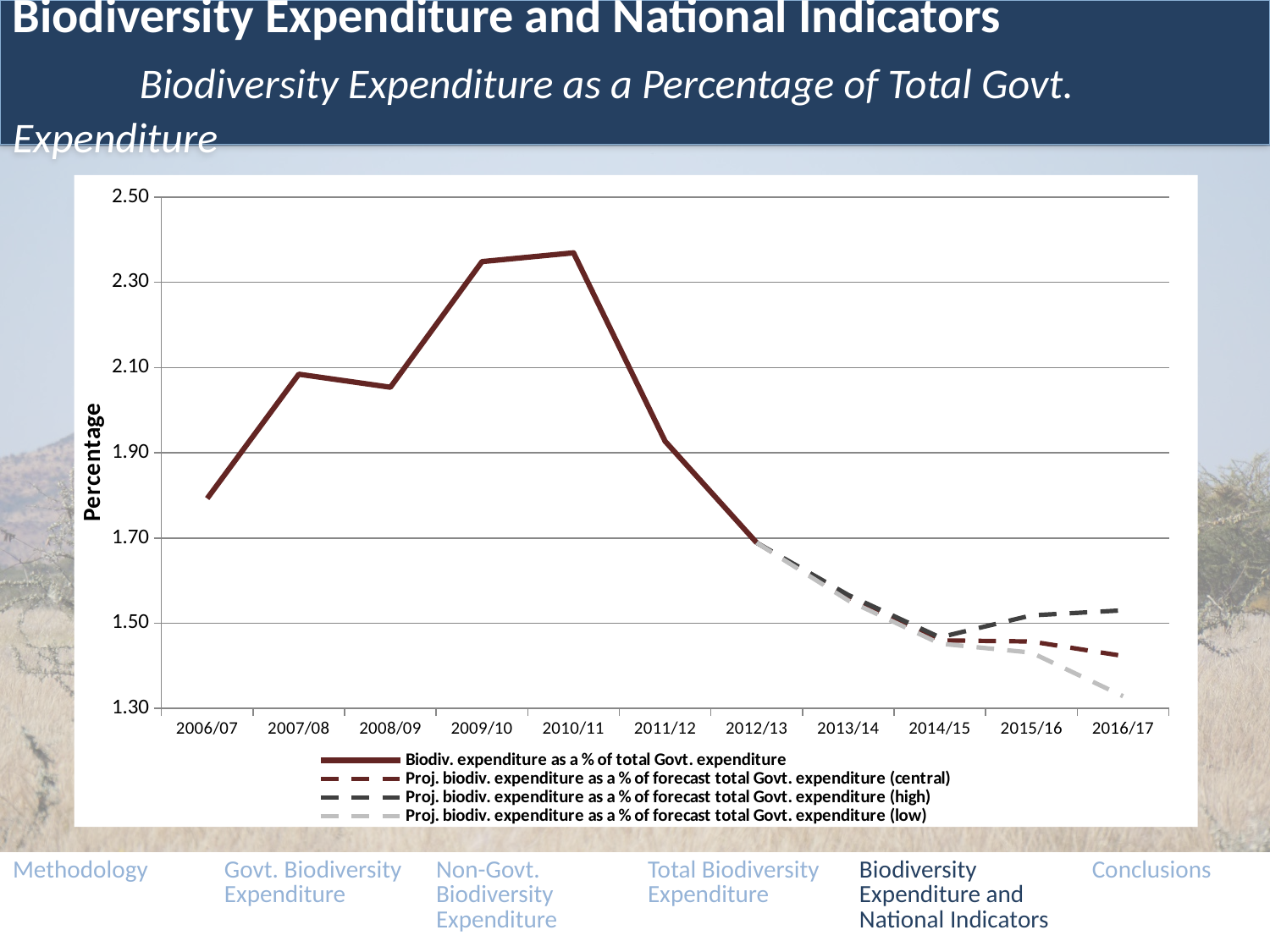
Is the value of the central projection series for 2016/17 greater or less than 1.50? less Is the value of the low projection series for 2016/17 greater or less than 1.50? less How many years are shown along the x axis of the chart? 11 What is the label on the chart's vertical axis? Percentage How many series does the chart's legend list? 4 Is the value of 'Biodiv. expenditure as a % of total Govt. expenditure' for 2010/11 greater or less than 2.30? greater What kind of chart is shown on the slide? Line chart In 2016/17, which projection series has the larger value: the high projection or the low projection? High projection Which year has the lowest value for the solid line 'Biodiv. expenditure as a % of total Govt. expenditure'? 2012/13 Which is larger for 'Biodiv. expenditure as a % of total Govt. expenditure': the value for 2006/07 or the value for 2009/10? 2009/10 Does the solid line 'Biodiv. expenditure as a % of total Govt. expenditure' rise or fall from 2010/11 to 2012/13? Fall